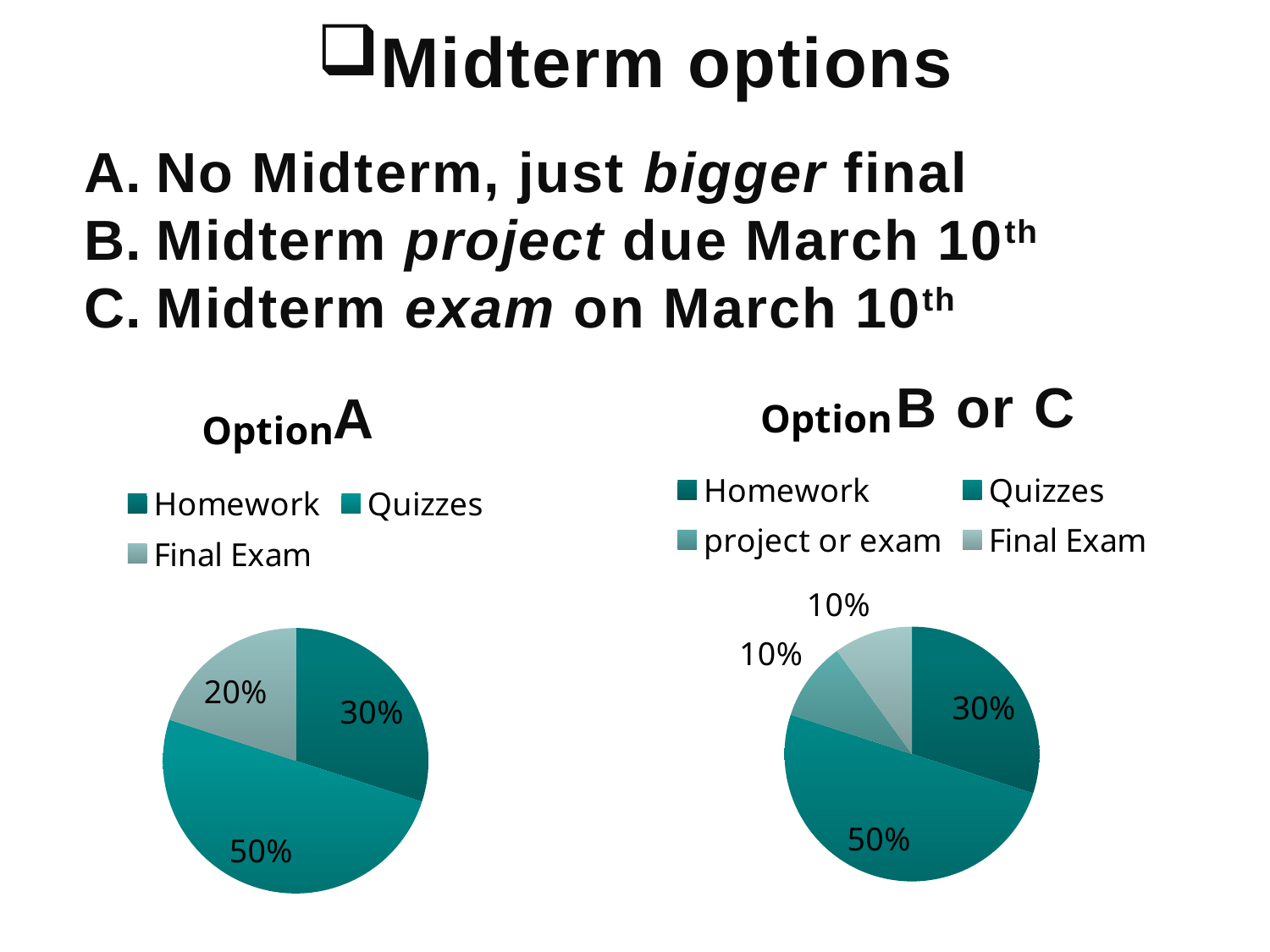
Which is larger: the Final Exam share in the Option A chart or the Final Exam share in the Option B or C chart? Option A In the Option A chart, which category has the smallest slice? Final Exam In the Option A chart, which category has the largest slice? Quizzes In the Option B or C chart, which category has the largest slice? Quizzes In the Option B or C chart, how many categories does the legend list? 4 In the Option A chart, what share does Final Exam have? 20% In the Option A chart, how many slices does the pie have? 3 In the Option B or C chart, what share does project or exam have? 10% What kind of chart is the Option B or C chart? Pie chart In the Option B or C chart, what share does Homework have? 30% In the Option A chart, what is the difference between the Quizzes share and the Homework share? 20% In the Option A chart, what share does Quizzes have? 50%